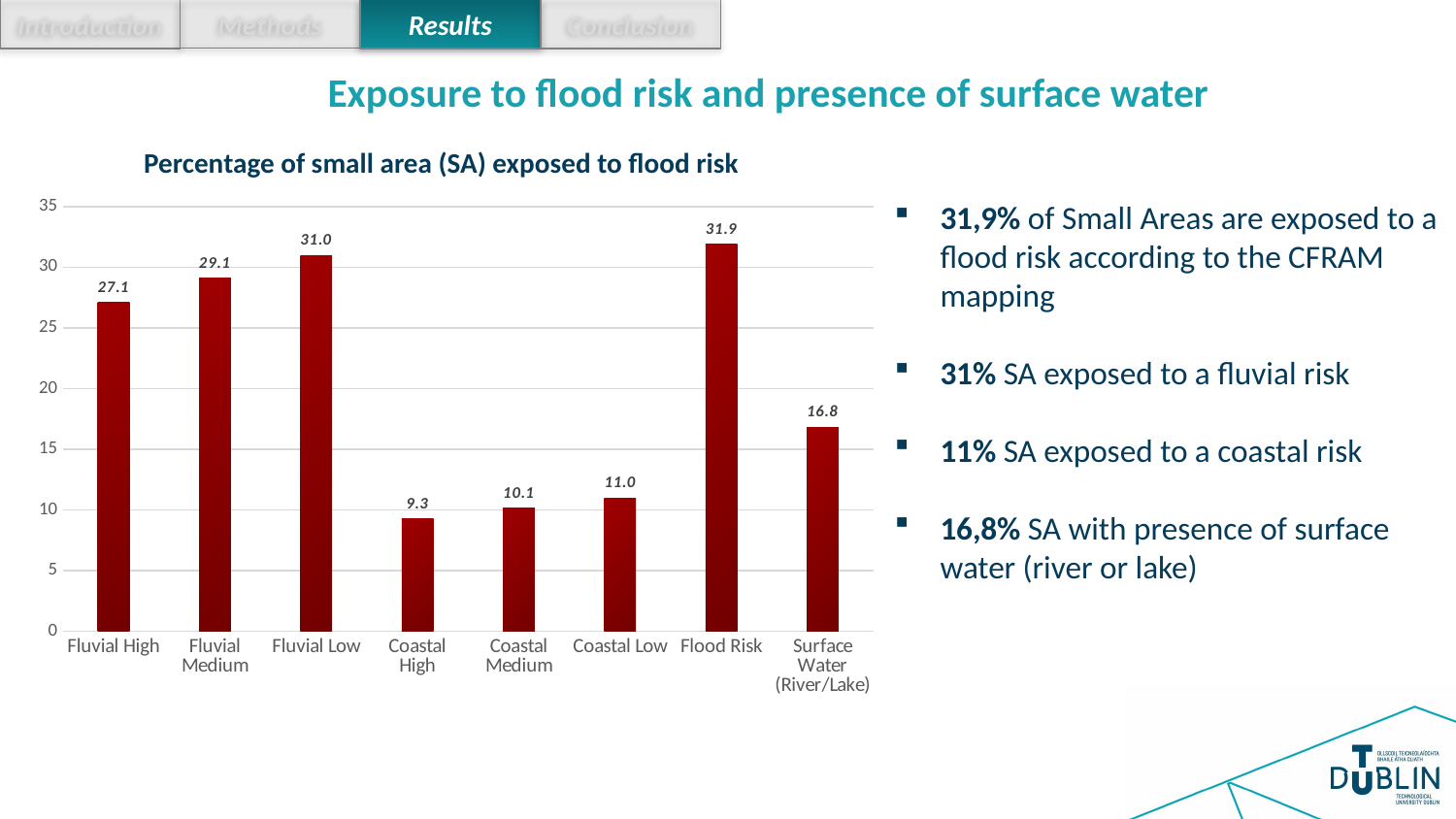
What is the value for Surface Water (River/Lake)? 16.8 What is the difference between Fluvial Low and Coastal Low? 20.0 Which category has the highest value? Flood Risk What is the difference between Flood Risk and Fluvial High? 4.8 Which category has the lowest value? Coastal High What is the title of the chart? Percentage of small area (SA) exposed to flood risk Which is larger, Fluvial Medium or Surface Water (River/Lake)? Fluvial Medium What is the value for Coastal Medium? 10.1 Is the value for Coastal High greater or less than 10? less What is the value for Fluvial High? 27.1 What kind of chart is shown? bar chart How many categories are shown on the x axis? 8